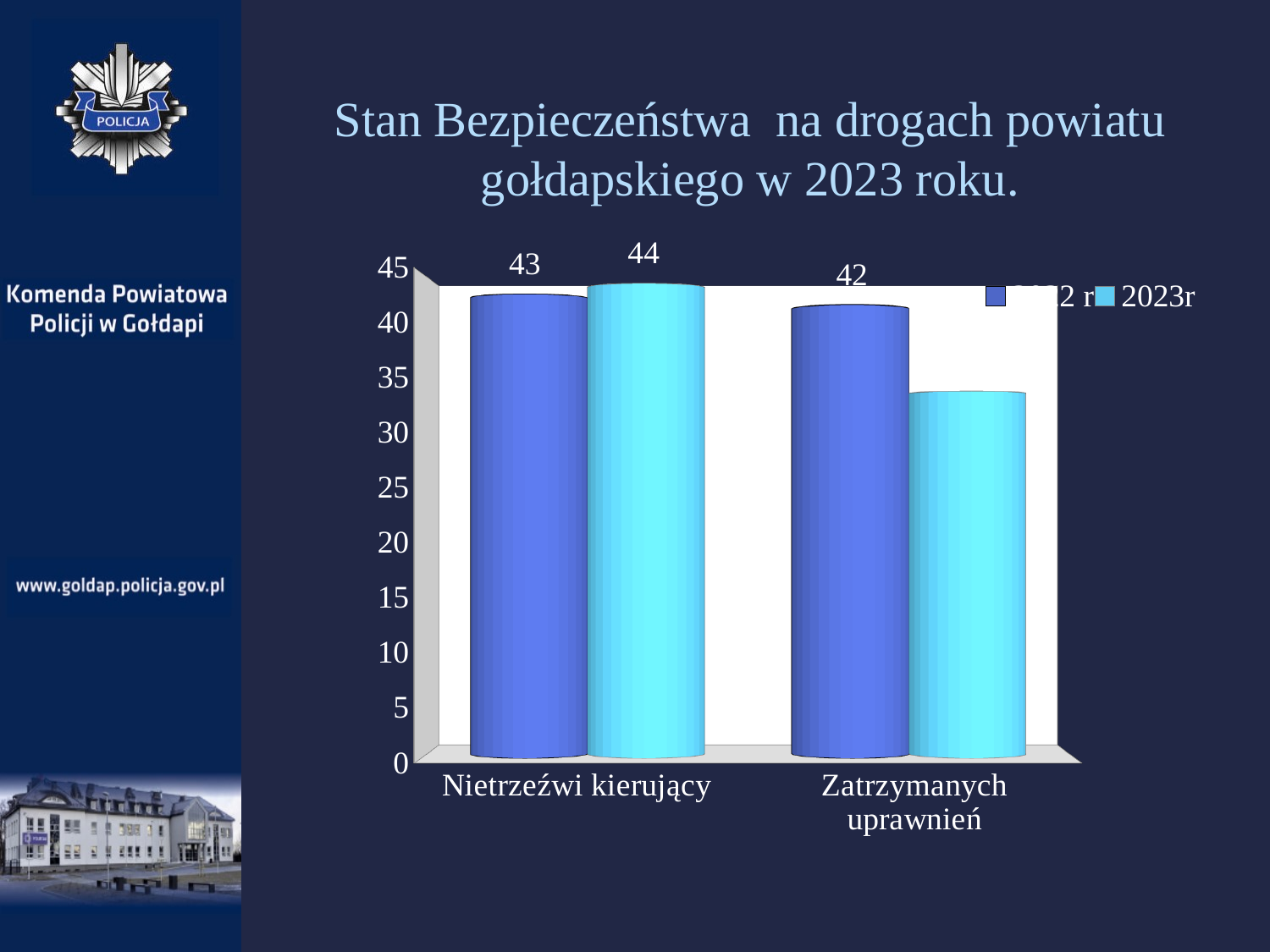
How many categories are shown on the x axis of the chart? 2 What is the value of the darker blue bar for Nietrzeźwi kierujący? 43 For Nietrzeźwi kierujący, which series has the larger value, the darker blue series or 2023r? 2023r For Zatrzymanych uprawnień, which bar is taller, the darker blue bar or the 2023r bar? the darker blue bar What is the 2023r value for Nietrzeźwi kierujący? 44 Is the 2023r value for Zatrzymanych uprawnień greater or less than 40? less What is the difference between the 2023r value and the darker blue series value for Nietrzeźwi kierujący? 1 What is the value of the darker blue bar for Zatrzymanych uprawnień? 42 What is the title of the chart on the slide? Stan Bezpieczeństwa na drogach powiatu gołdapskiego w 2023 roku. What kind of chart is shown on the slide? bar chart How many series does the chart's legend list? 2 Which bar has the highest labelled value in the chart? 2023r for Nietrzeźwi kierujący (44)